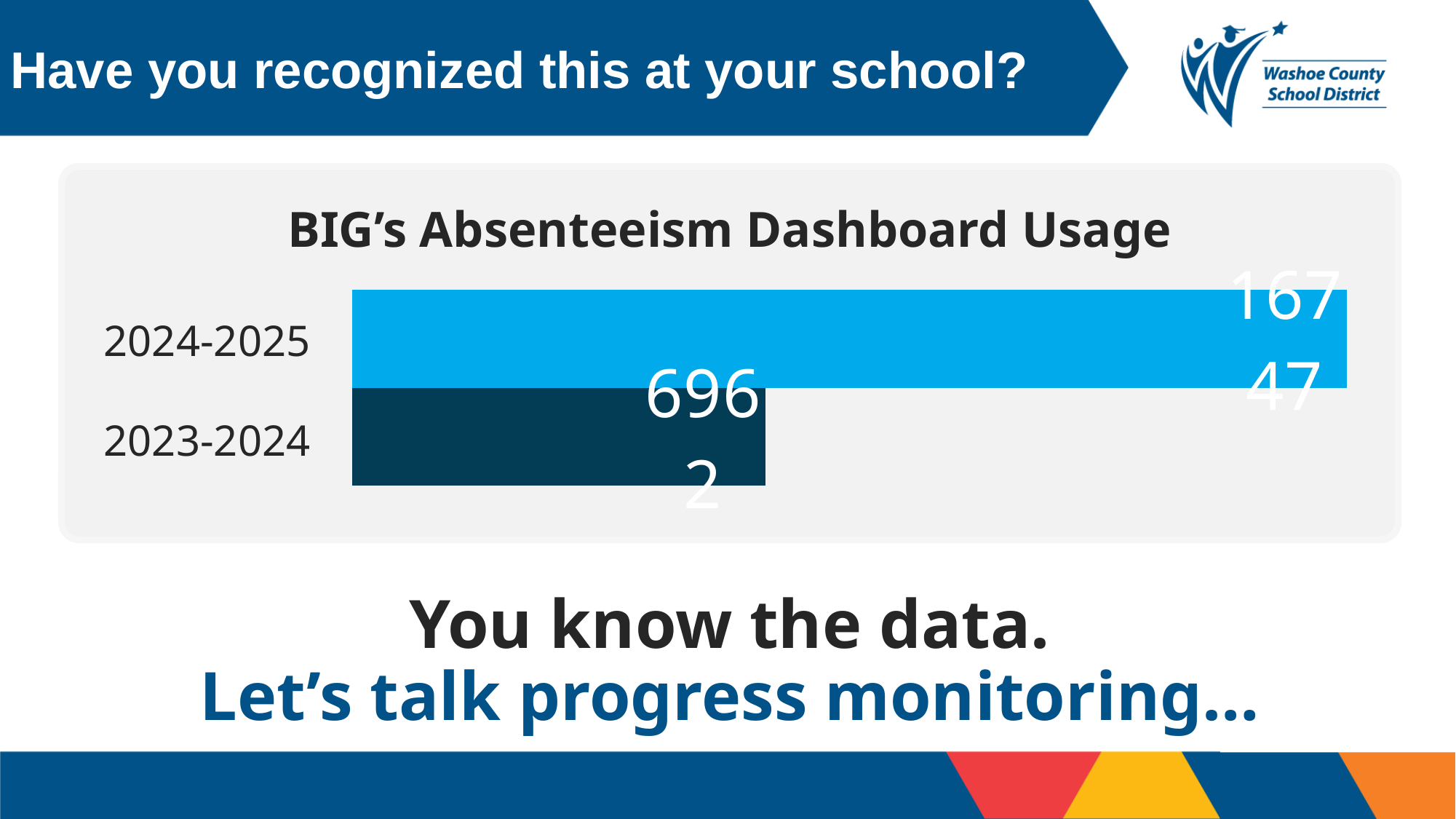
Which school year has the lowest dashboard usage in the chart? 2023-2024 What is the value for 2024-2025 in the BIG's Absenteeism Dashboard Usage chart? 16747 Which is larger in the chart, the value for 2024-2025 or the value for 2023-2024? 2024-2025 What is the value for 2023-2024 in the BIG's Absenteeism Dashboard Usage chart? 6962 Which school year has the highest dashboard usage in the chart? 2024-2025 How many school years are shown in the chart? 2 Which school year's bar is drawn in the lighter blue colour? 2024-2025 What is the difference between the 2024-2025 and 2023-2024 values in the chart? 9785 Did dashboard usage rise or fall from 2023-2024 to 2024-2025? Rise What is the title of the chart on the slide? BIG's Absenteeism Dashboard Usage What kind of chart is shown on the slide? Bar chart